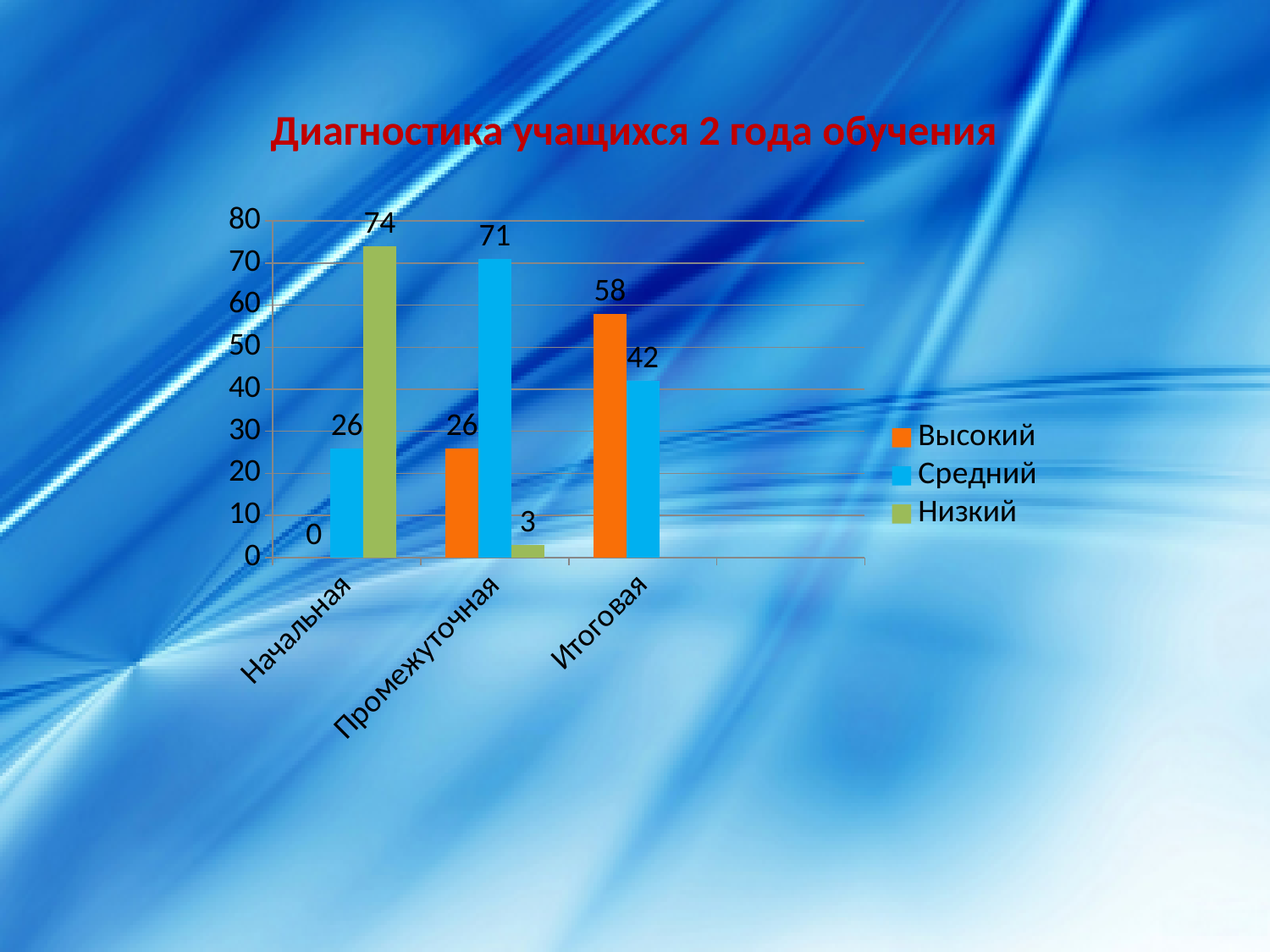
What is the value for Средний in the Промежуточная category? 71 What is the value for Низкий in the Начальная category? 74 Which is larger in the Итоговая category: Высокий or Средний? Высокий In which category is the Высокий series highest? Итоговая What is the difference between the Средний values for Промежуточная and Итоговая? 29 What is the value for Средний in the Начальная category? 26 How many categories are shown on the x axis? 3 In which category is the Высокий series lowest? Начальная What is the value for Низкий in the Промежуточная category? 3 What kind of chart is shown on the slide? Bar chart How many series does the legend list? 3 What is the value for Высокий in the Итоговая category? 58